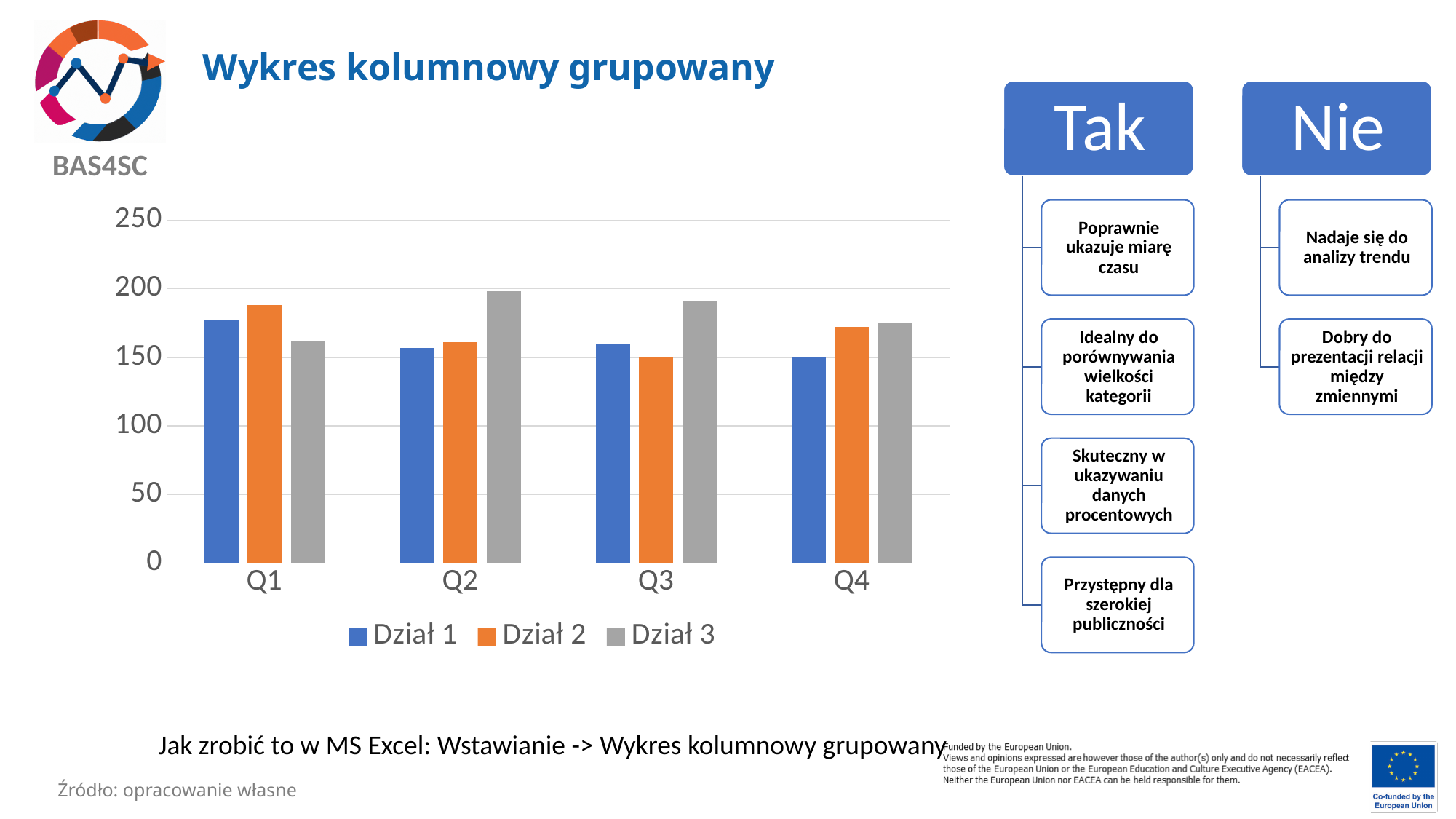
Is the value for Dział 3 in Q2 greater or less than 150? greater Is the value for Dział 2 in Q1 greater or less than 200? less Which series has the lowest bar in Q3? Dział 2 Which series has the highest bar in Q2? Dział 3 Which series has the lowest bar in Q4? Dział 1 How many categories are shown on the x axis of the chart? 4 What is the title of the chart on the slide? Wykres kolumnowy grupowany Which series has the highest bar in Q3? Dział 3 What kind of chart is shown on the slide? Bar chart In Q1, which is larger: the value for Dział 1 or Dział 3? Dział 1 How many series does the chart legend list? 3 What colour represents Dział 2 in the chart legend? Orange